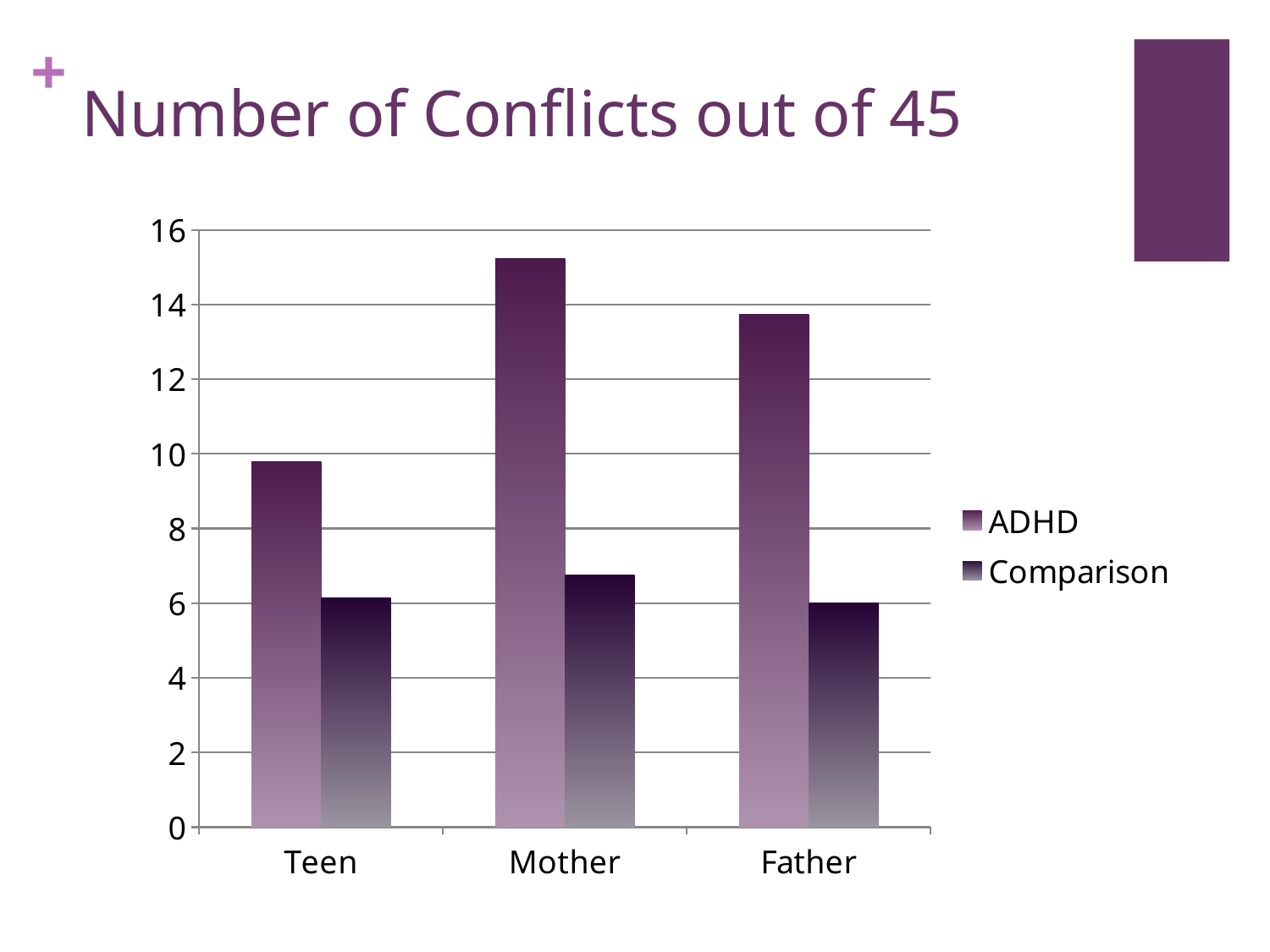
How many categories are shown on the x axis? 3 Which category has the highest Comparison value? Mother How many series does the legend list? 2 Is the ADHD value for Mother greater or less than 14? greater Is the Comparison value for Mother greater or less than 8? less What kind of chart is shown on the slide? bar chart Which category has the lowest ADHD value? Teen Which is larger: the ADHD value for Father or the ADHD value for Teen? Father What is the title of the slide? Number of Conflicts out of 45 Which is larger for Father: the ADHD value or the Comparison value? ADHD Which category has the highest ADHD value? Mother